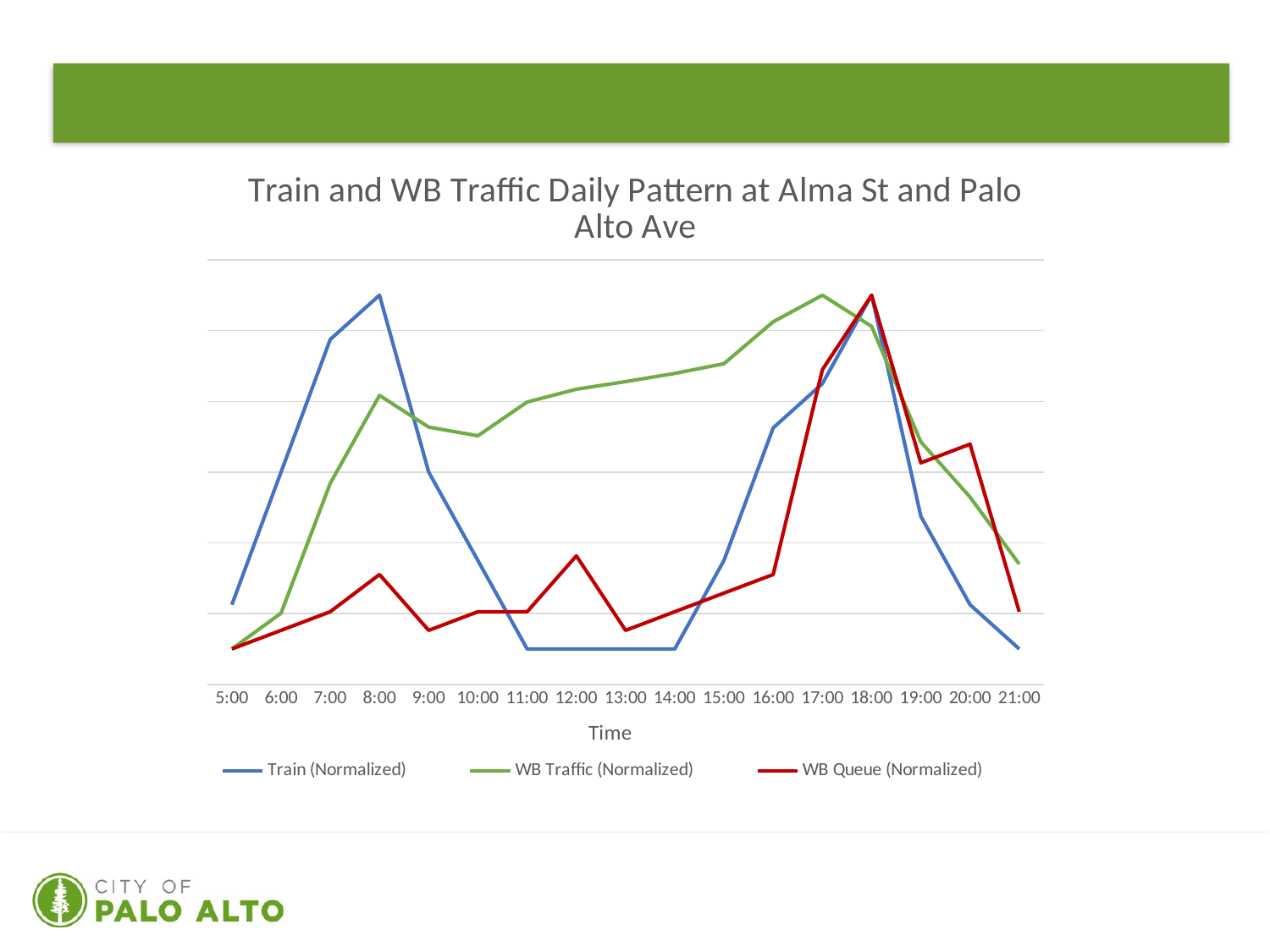
What is the title of the chart? Train and WB Traffic Daily Pattern at Alma St and Palo Alto Ave How many time points are shown along the x axis? 17 Does the Train (Normalized) series rise or fall between 8:00 and 11:00? Fall At 8:00, which series is higher: Train (Normalized) or WB Traffic (Normalized)? Train (Normalized) At what time does the WB Queue (Normalized) series reach its highest value? 18:00 How many series does the legend list? 3 At 12:00, which series is higher: WB Traffic (Normalized) or Train (Normalized)? WB Traffic (Normalized) Does the WB Traffic (Normalized) series rise or fall between 10:00 and 17:00? Rise At what time is the WB Traffic (Normalized) series at its lowest value? 5:00 What kind of chart is shown on the slide? Line chart At what time does the Train (Normalized) series reach its highest value? 8:00 and 18:00 At what time does the WB Traffic (Normalized) series reach its highest value? 17:00